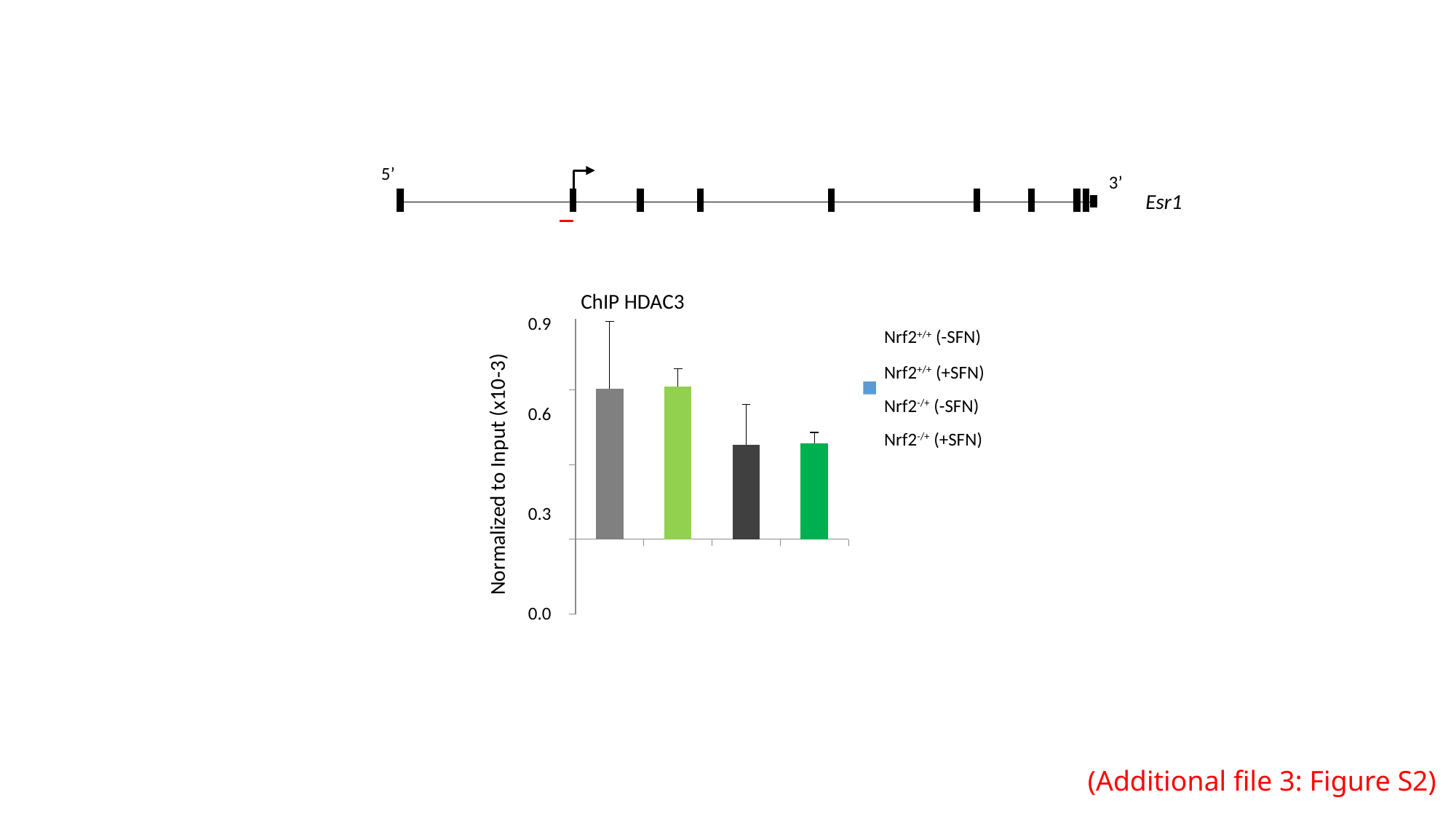
What is the label of the y axis of the ChIP HDAC3 chart? Normalized to Input (x10-3) What is the title of the chart? ChIP HDAC3 In the ChIP HDAC3 chart, which is larger: the first (gray) bar or the third (dark gray) bar? the first (gray) bar In the ChIP HDAC3 chart, is the value of the fourth (green) bar greater or less than 0.3? greater In the ChIP HDAC3 chart, is the value of the second (light green) bar greater or less than 0.6? greater In the ChIP HDAC3 chart, is the value of the first (gray) bar greater or less than 0.6? greater In the ChIP HDAC3 chart, do the bar values generally rise or fall from left to right? fall How many bars are plotted in the ChIP HDAC3 chart? 4 In the ChIP HDAC3 chart, which is larger: the second (light green) bar or the fourth (green) bar? the second (light green) bar How many entries does the legend of the ChIP HDAC3 chart list? 4 What kind of chart is shown on the slide? bar chart